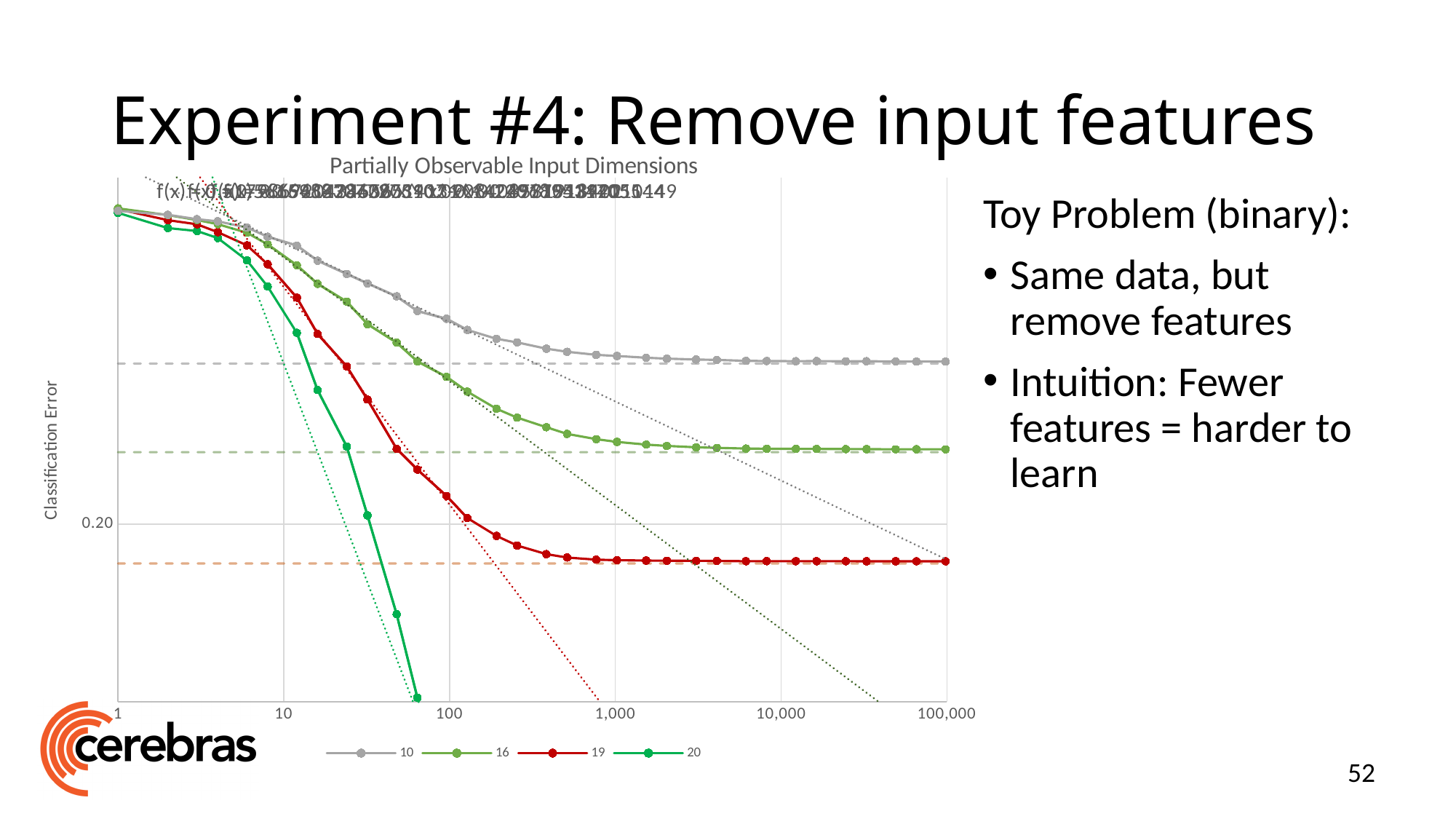
Is the classification error for series 16 at 100,000 greater or less than 0.20? greater At 100,000 on the x axis, which series has the lower classification error, 16 or 19? 19 Do the classification error values rise or fall as the x axis increases? fall Which series drops to the lowest classification error on the chart? 20 What is the title of the chart? Partially Observable Input Dimensions How many series does the chart legend list? 4 Is the classification error for series 19 at 100,000 greater or less than 0.20? less What kind of chart is shown on the slide? line chart What is the label on the y axis of the chart? Classification Error How many labelled tick marks are on the x axis? 6 Is the classification error for series 10 at 100,000 greater or less than 0.20? greater Which series has the highest classification error at 100,000 on the x axis? 10